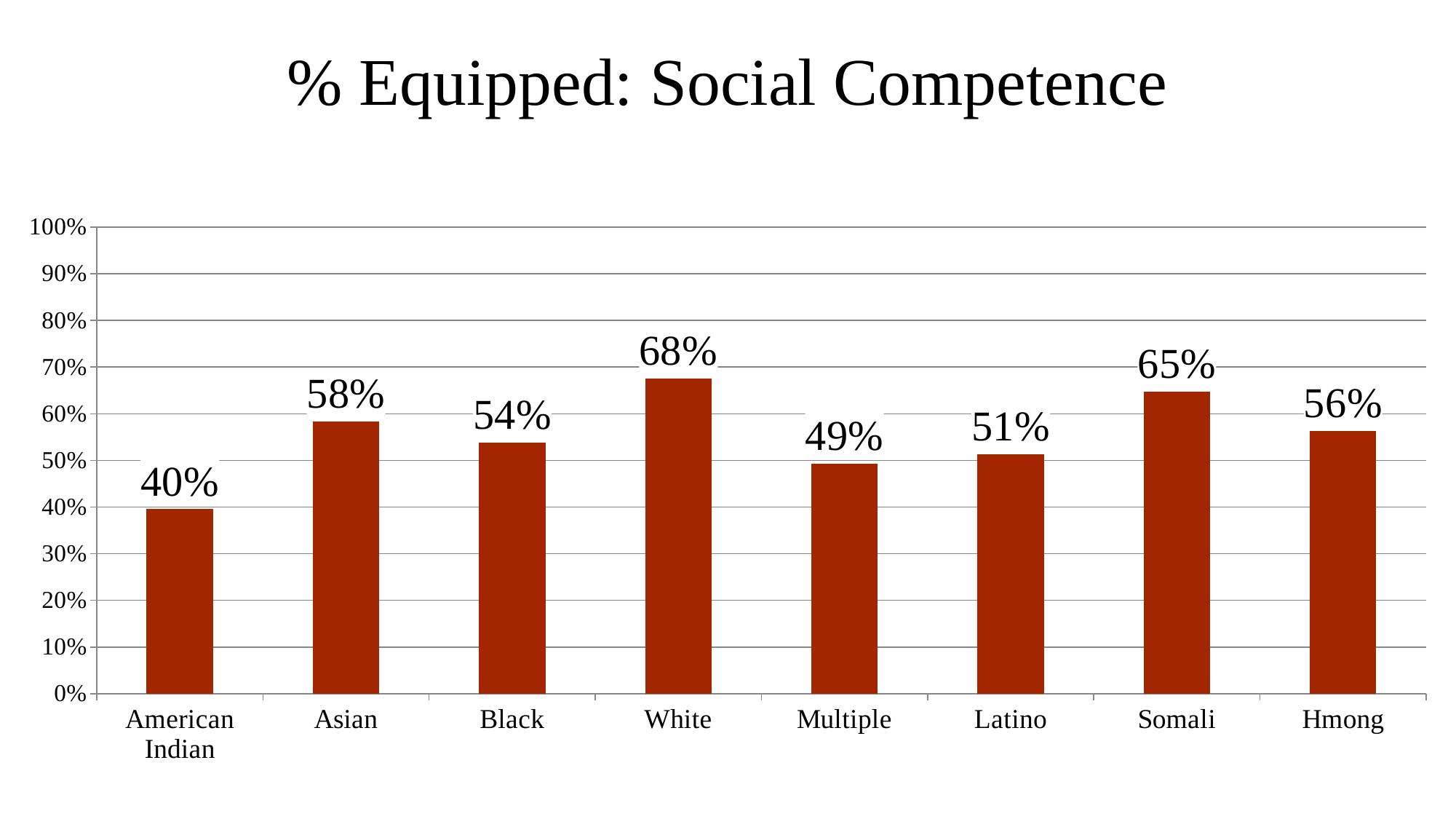
How many categories are shown on the x axis? 8 What is the value for White? 68% What is the difference between the values for White and American Indian? 28% Which category has the highest value? White What kind of chart is shown on the slide? Bar chart What is the difference between the values for Asian and Hmong? 2% What is the value for American Indian? 40% Which category has the lowest value? American Indian What is the value for Multiple? 49% What is the title of the chart? % Equipped: Social Competence Which is larger, the value for Black or the value for Latino? Black What is the value for Somali? 65%